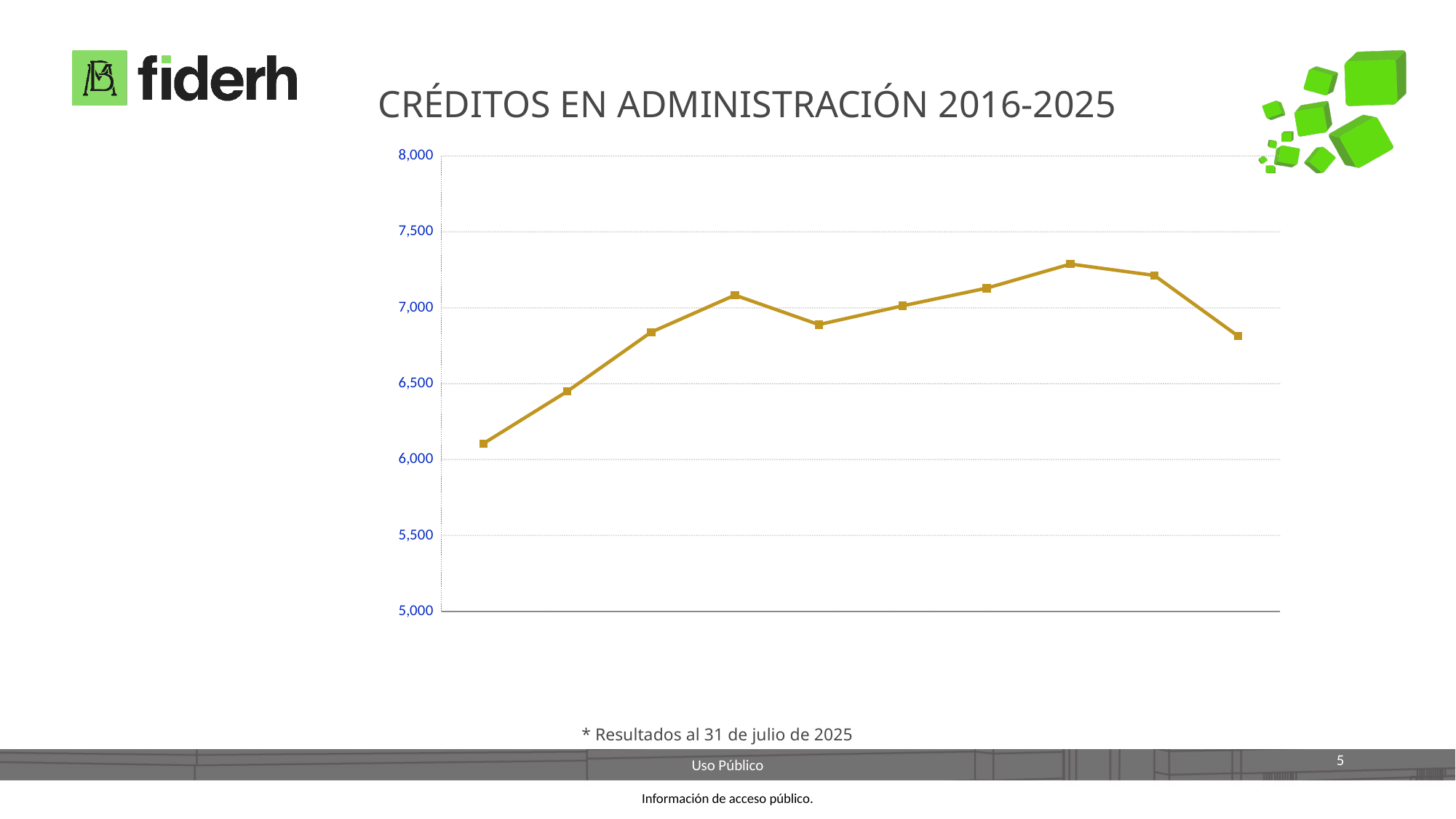
Do the values rise or fall from the first point to the fourth point? rise Is the value of the highest point on the line greater or less than 7,000? greater Is the value of the third point from the left greater or less than 6,500? greater What is the title of the chart? CRÉDITOS EN ADMINISTRACIÓN 2016-2025 What is the highest value shown on the vertical axis? 8,000 Is the value of the first (leftmost) point greater or less than 6,500? less How many data points are plotted on the line? 10 Do the values rise or fall from the eighth point to the last point? fall Which is larger, the value of the first point or the value of the last point? the last point Which is larger, the value of the fourth point or the value of the fifth point from the left? the fourth point What kind of chart is shown on the slide? line chart